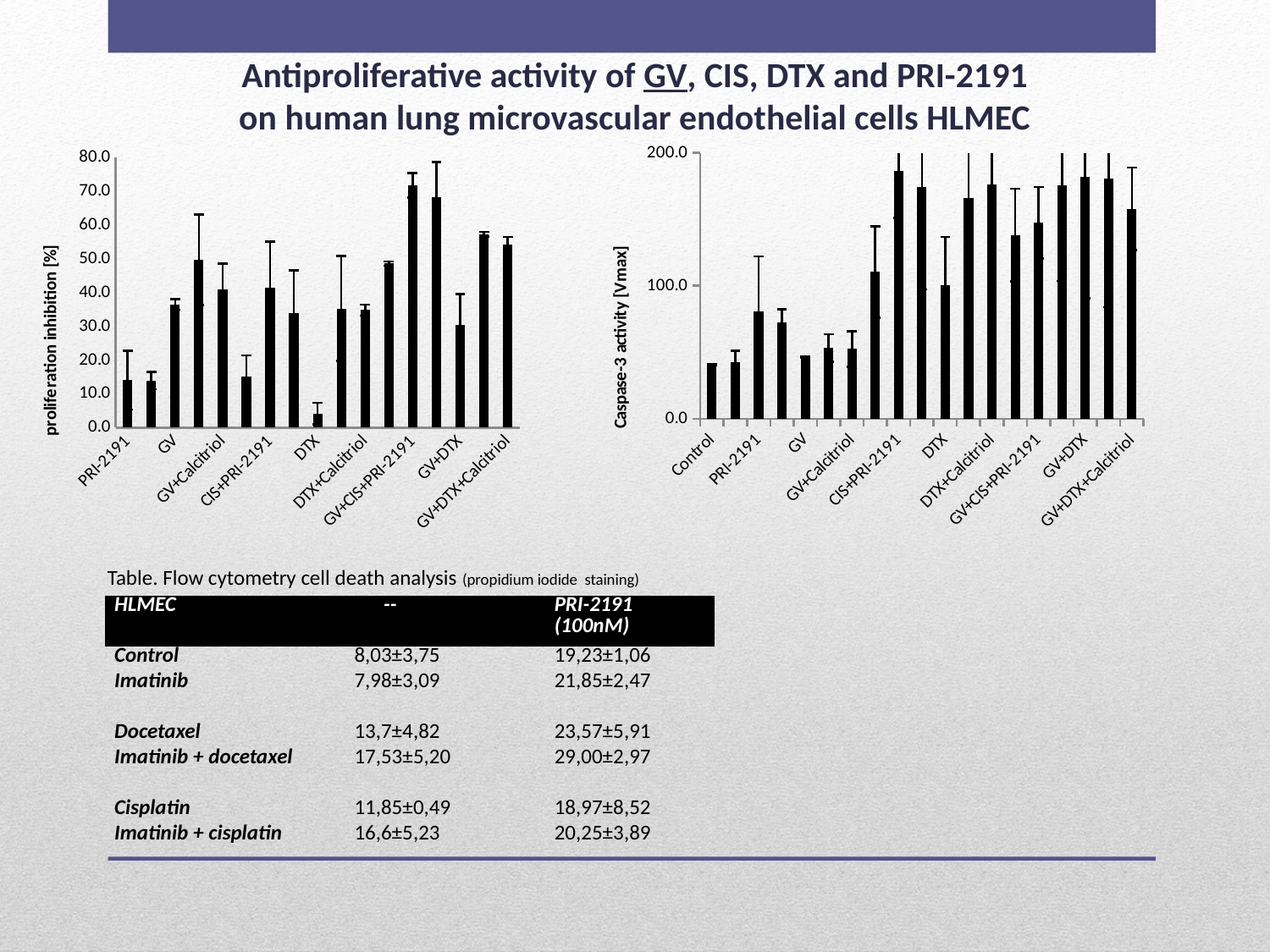
How many charts are shown on the slide? 2 What kind of chart is the left chart on the slide? bar chart In the left chart (proliferation inhibition), is the value for PRI-2191 greater or less than 20? less What is the highest tick value on the y-axis of the right chart? 200.0 In the right chart (Caspase-3 activity), is the value for Control greater or less than 100? less In the right chart (Caspase-3 activity), is the tallest bar greater or less than 150? greater What kind of chart is the right chart on the slide? bar chart What is the y-axis label of the right chart? Caspase-3 activity [Vmax] What is the y-axis label of the left chart? proliferation inhibition [%]